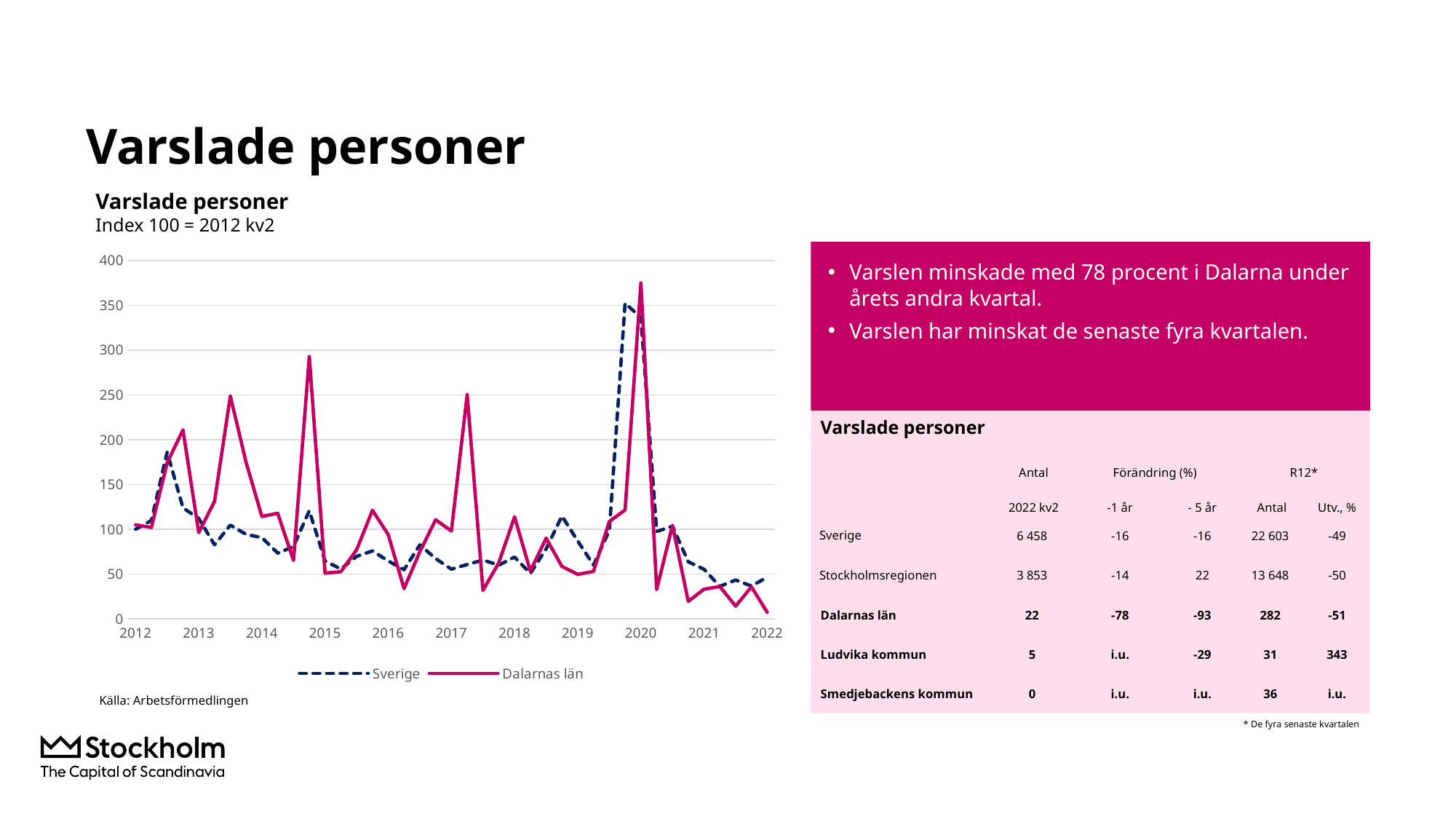
Is the peak value for Sverige in 2020 greater or less than 300? greater Which series reaches the highest value on the chart? Dalarnas län What kind of chart is shown on the slide? line chart How many series does the chart legend list? 2 Is the peak value for Dalarnas län in 2020 greater or less than 350? greater Do the values for Dalarnas län rise or fall from the 2020 peak to 2022? fall Is the Dalarnas län peak just before 2015 greater or less than 250? greater What is the index base stated under the chart title? Index 100 = 2012 kv2 Which two series are listed in the chart legend? Sverige and Dalarnas län How many year labels are shown on the x axis? 11